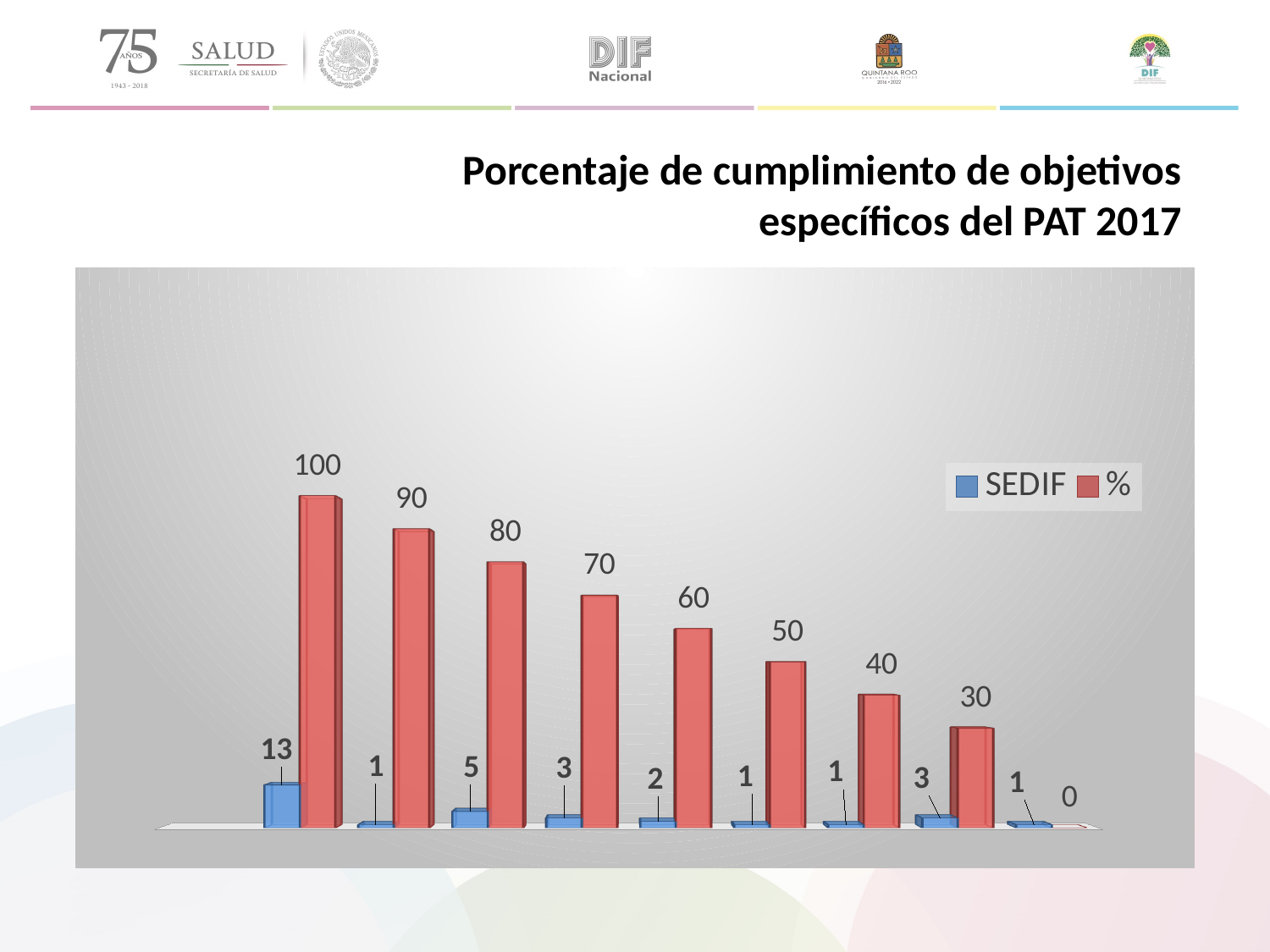
Which is larger: the SEDIF value in the 80% group or the SEDIF value in the 60% group? the 80% group What is the highest SEDIF value shown in the chart? 13 What kind of chart is shown on the slide? bar chart What is the SEDIF value in the group where the % value is 80? 5 How many groups of bars are plotted in the chart? 9 What is the difference between the SEDIF value in the 100% group and the SEDIF value in the 90% group? 12 What is the % value of the first group of bars on the left? 100 What is the SEDIF value in the group where the % value is 30? 3 Do the % values rise or fall from left to right across the chart? fall What are the two series named in the legend? SEDIF and % How many series does the legend list? 2 What is the lowest % value shown in the chart? 0